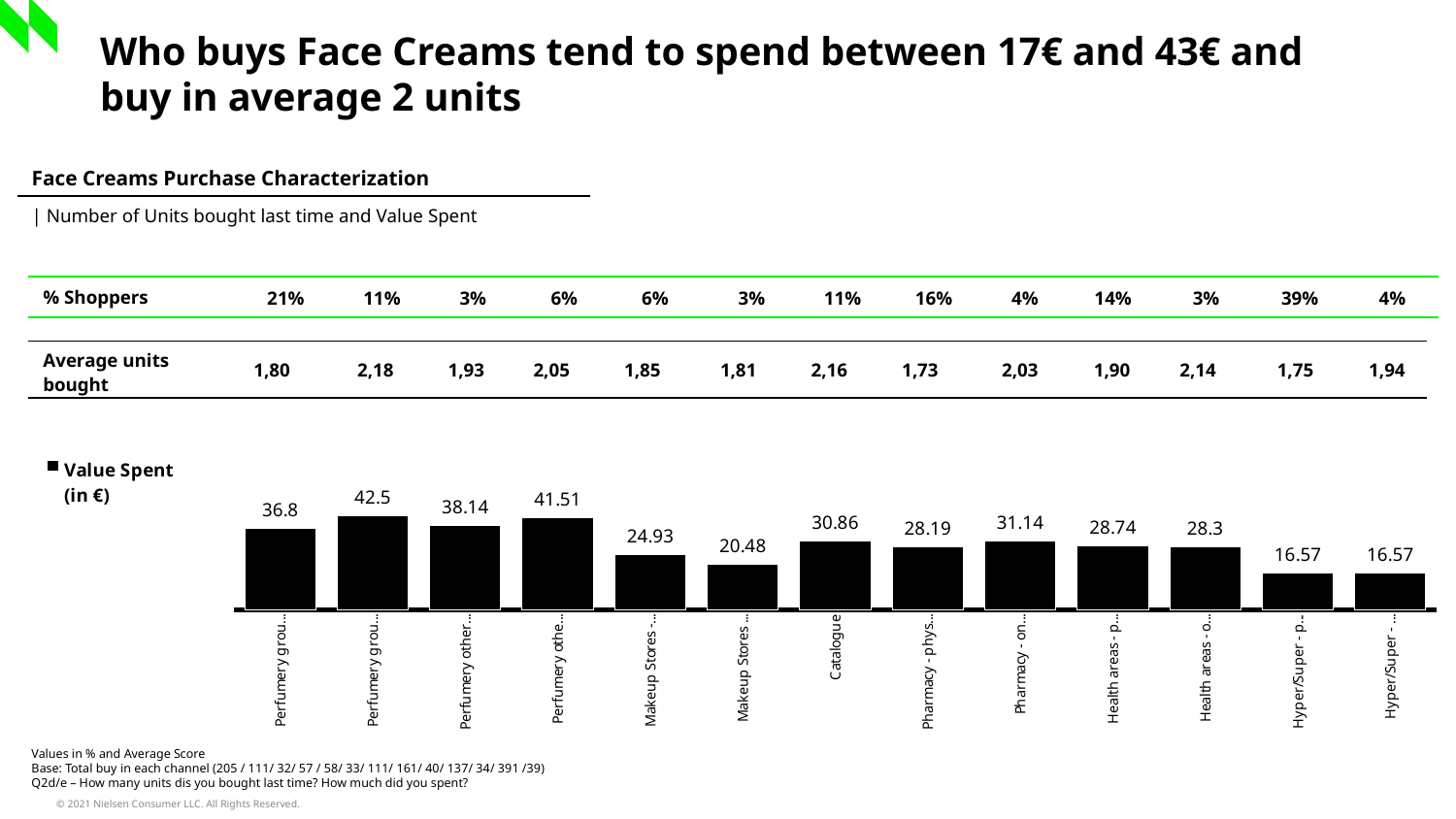
What is the highest value spent shown in the chart? 42.5 What is the value shown on the first (leftmost) bar of the chart? 36.8 What is the value spent for Catalogue? 30.86 How many series does the chart's legend list? 1 What is the difference between the highest value in the chart (42.5) and the value for Catalogue (30.86)? 11.64 What is the legend entry for the series plotted in the chart? Value Spent (in €) What is the value shown on the rightmost bar of the chart? 16.57 What is the difference between the second bar from the left (42.5) and the first bar from the left (36.8)? 5.7 What kind of chart is shown on the slide? Bar chart Which is larger: the value for Catalogue or the value of the bar immediately to its right? Catalogue How many bars does the chart contain? 13 What is the lowest value spent shown in the chart? 16.57